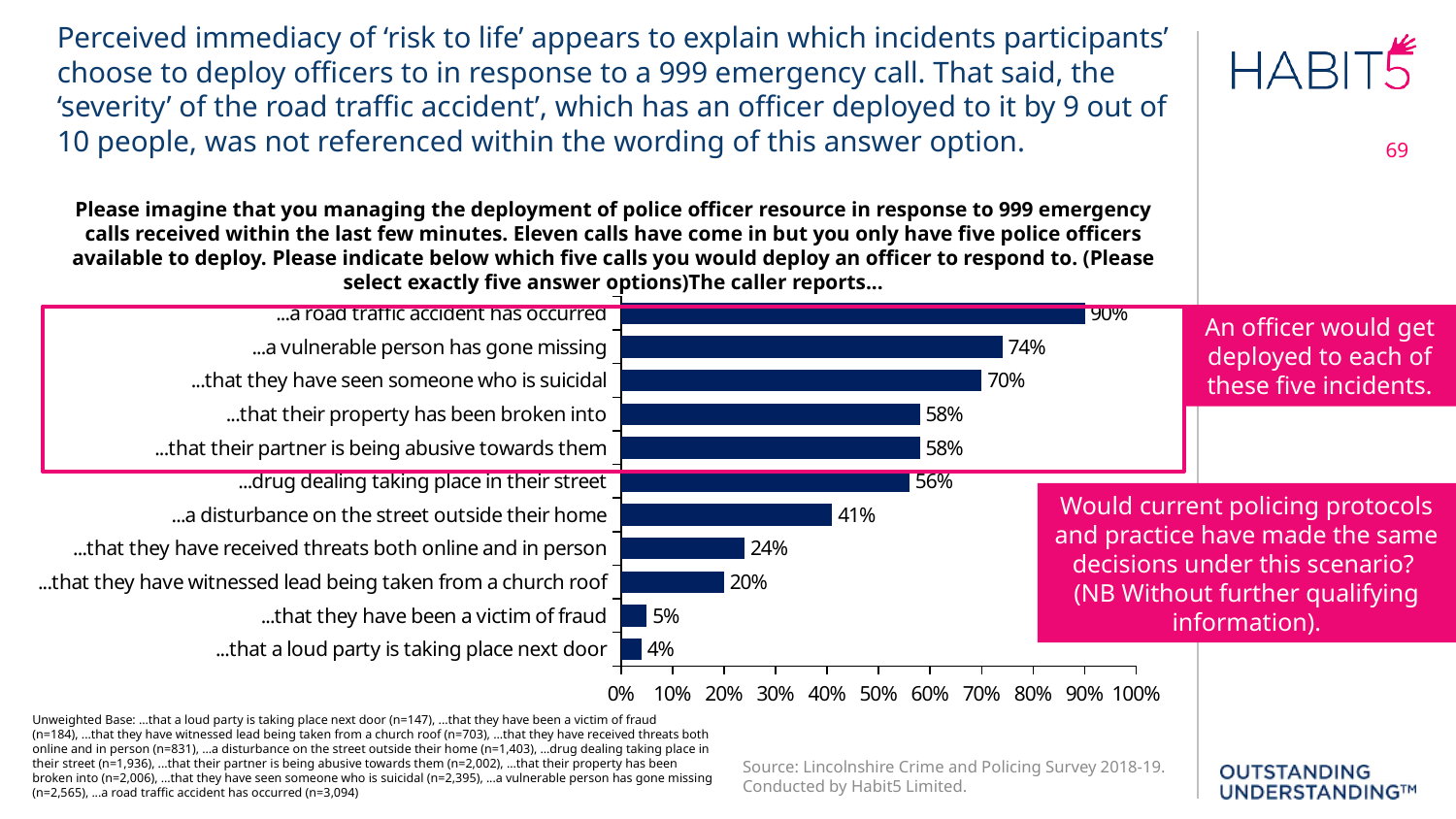
Which has a larger value: '...drug dealing taking place in their street' or '...a disturbance on the street outside their home'? ...drug dealing taking place in their street What kind of chart is shown on the slide? Bar chart What is the difference between the values for '...a disturbance on the street outside their home' and '...that they have received threats both online and in person'? 17% What is the difference between the values for '...a road traffic accident has occurred' and '...a vulnerable person has gone missing'? 16% Which incident has the highest percentage of participants deploying an officer? ...a road traffic accident has occurred What percentage is shown for '...that they have witnessed lead being taken from a church roof'? 20% Is the value for '...that they have seen someone who is suicidal' greater or less than 60%? greater What is the value for '...a vulnerable person has gone missing'? 74% What is the value for '...that they have been a victim of fraud'? 5% Which incident has the lowest percentage? ...that a loud party is taking place next door What percentage of participants would deploy an officer to a road traffic accident? 90% How many incident categories are plotted in the chart? 11